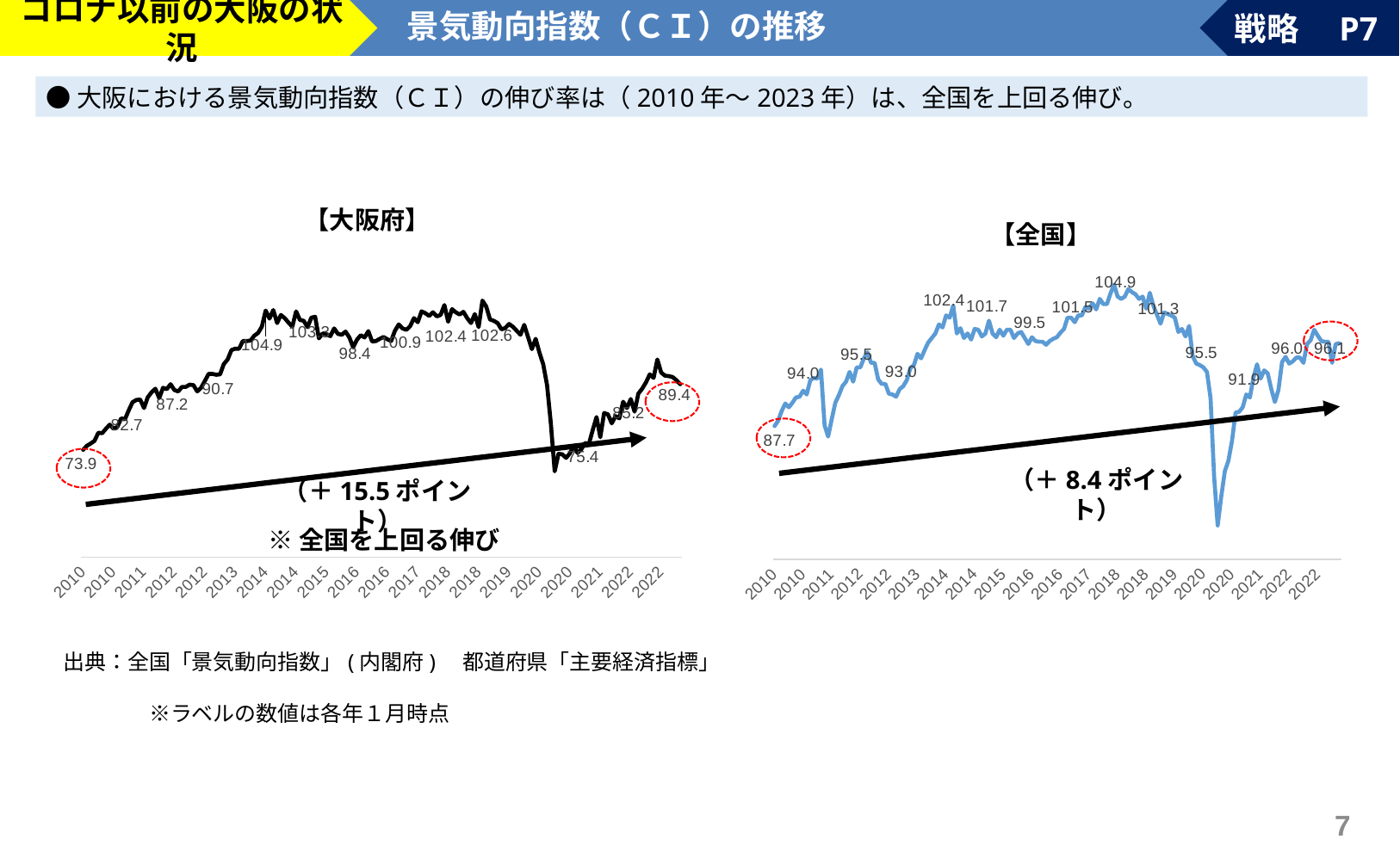
In the 【大阪府】 chart, what is the lowest labelled value? 73.9 In the 【全国】 chart, what is the first labelled value (circled, at 2010)? 87.7 In the 【全国】 chart, what is the last labelled value (circled, at 2022)? 96.1 In the 【大阪府】 chart, what is the difference between the last labelled value (89.4) and the first labelled value (73.9)? 15.5 In the 【大阪府】 chart, what is the first labelled value (circled, at 2010)? 73.9 In the 【全国】 chart, what is the difference between the last labelled value (96.1) and the first labelled value (87.7)? 8.4 Which is larger, the 2010 labelled value in the 【大阪府】 chart or the 2010 labelled value in the 【全国】 chart? 【全国】 In the 【全国】 chart, what is the highest labelled value? 104.9 In the 【大阪府】 chart, what is the last labelled value (circled, at 2022)? 89.4 What kind of chart is the 【大阪府】 chart? line chart Which chart shows the larger increase in points from 2010 to 2022, 【大阪府】 or 【全国】? 【大阪府】 In the 【全国】 chart, what is the lowest labelled value? 87.7